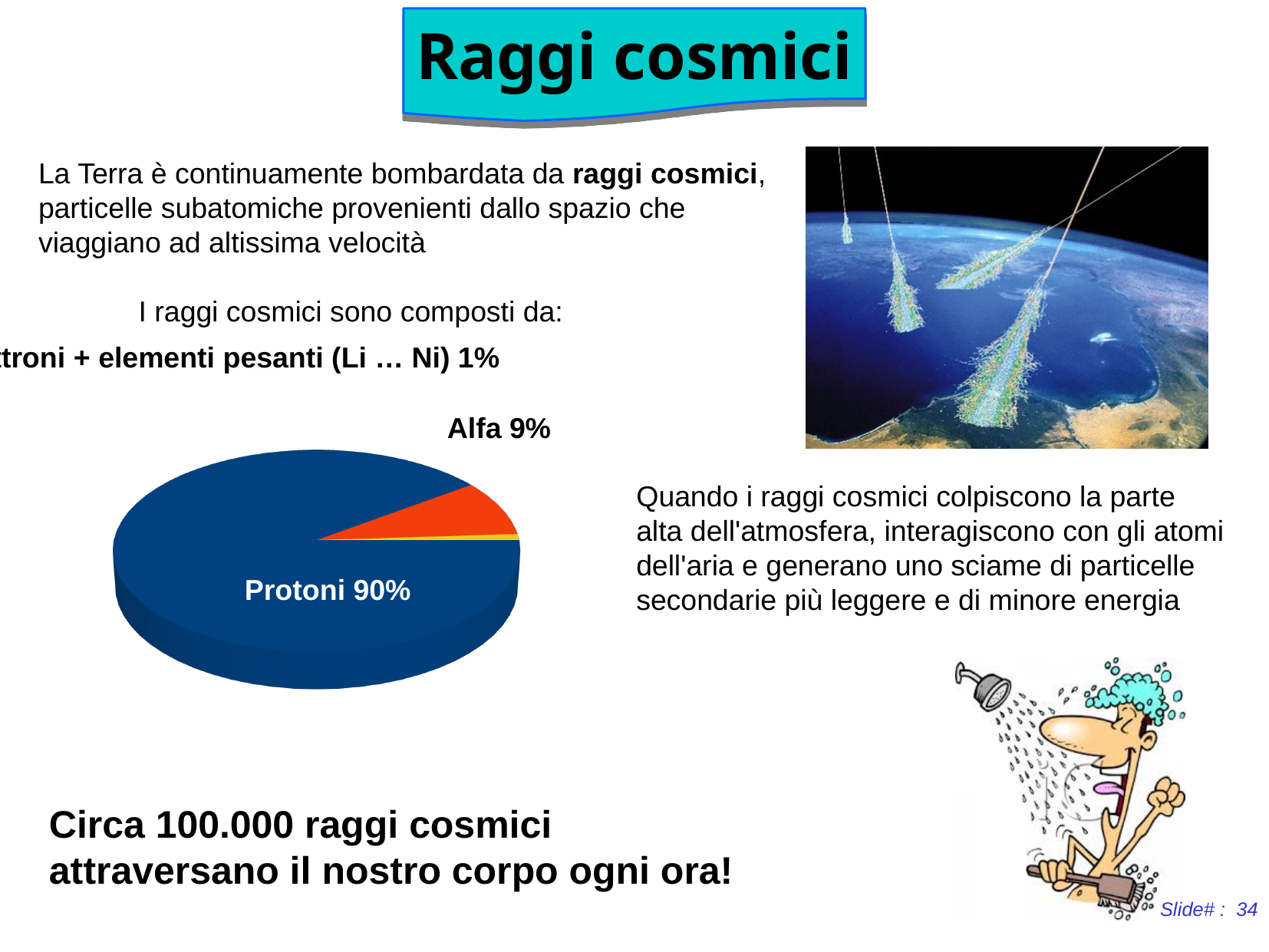
What is the difference in percentage points between the Protoni slice and the Alfa slice? 81% What percentage is shown for the slice labelled '... + elementi pesanti (Li … Ni)'? 1% What percentage does the pie chart show for Alfa? 9% How many slices does the pie chart have? 3 Which slice of the pie chart is the largest? Protoni What colour is the Protoni slice of the pie chart? blue What do the Protoni and Alfa slices add up to? 99% What share of the pie does the Alfa slice take? 9% Which is larger in the pie chart, Protoni or Alfa? Protoni What percentage does the smallest slice of the pie chart represent? 1% What percentage of cosmic rays does the pie chart attribute to Protoni? 90% What kind of chart is shown on the slide? pie chart